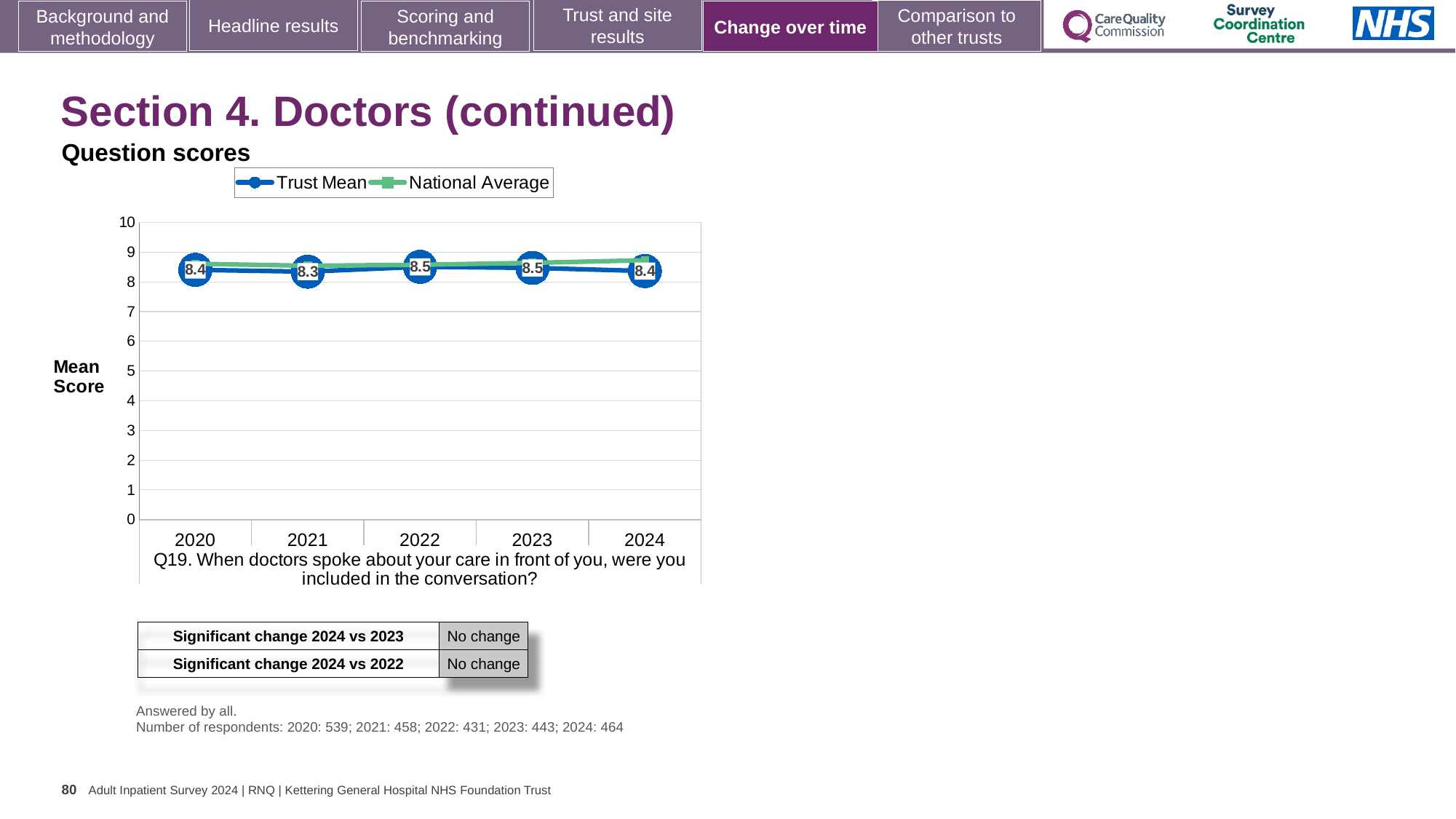
What kind of chart is shown? line chart Is the National Average value for 2024 greater or less than 8? greater What is the Trust Mean score for 2020? 8.4 How many series does the legend list? 2 What is the Trust Mean score for 2021? 8.3 What is the difference between the Trust Mean scores for 2022 and 2021? 0.2 Between 2021 and 2022, does the Trust Mean score rise or fall? rise Which year has the larger Trust Mean score, 2021 or 2023? 2023 What is the label on the y axis? Mean Score How many years are plotted on the x axis? 5 In which year is the Trust Mean score lowest? 2021 What is the Trust Mean score for 2024? 8.4